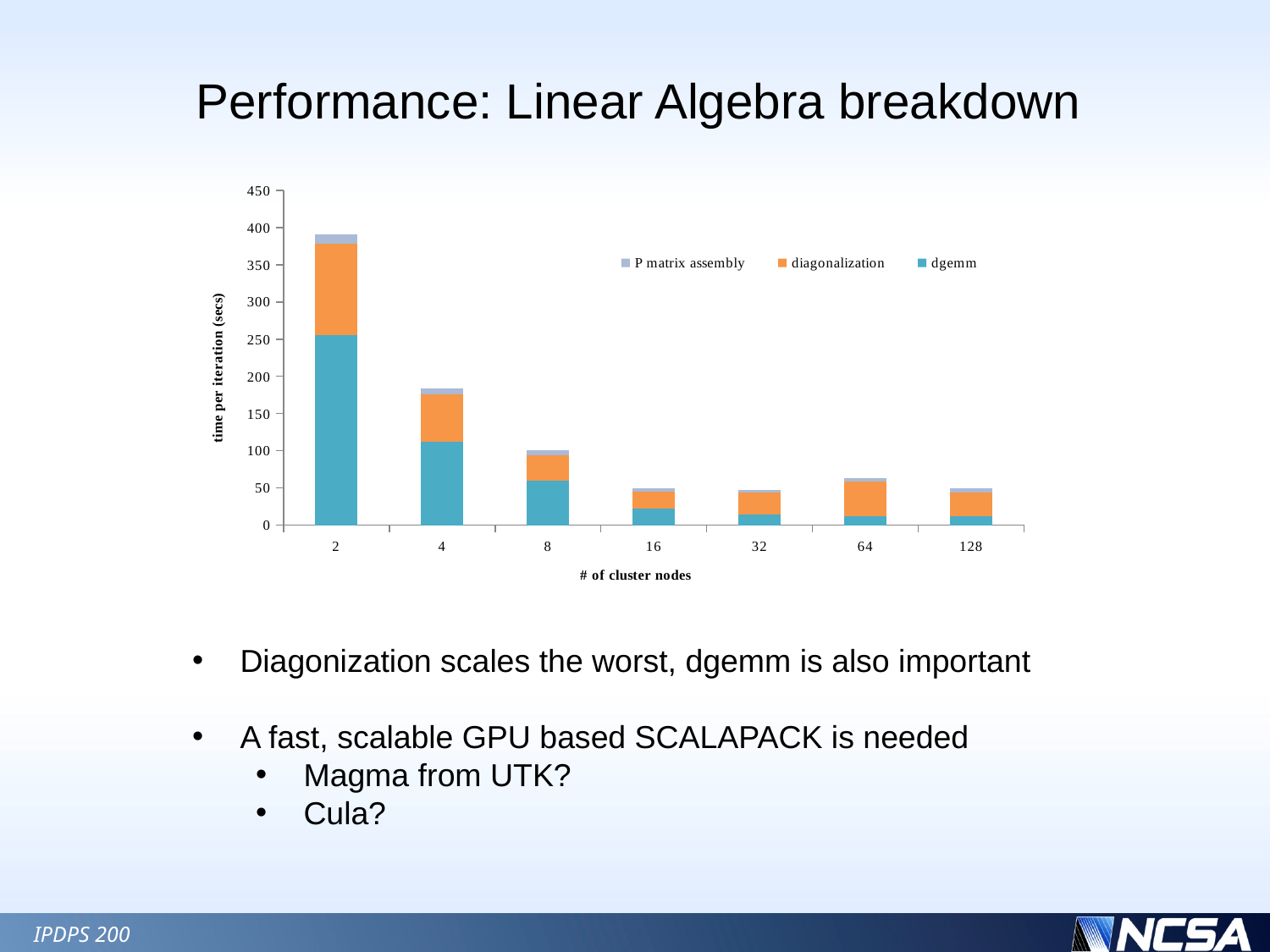
Is the total time per iteration for 2 cluster nodes greater or less than 350? greater How many cluster-node categories are shown on the x axis? 7 What kind of chart is shown on the slide? bar chart Which has a larger total time per iteration, 2 cluster nodes or 4 cluster nodes? 2 cluster nodes How many series does the legend list? 3 What is the label of the y axis? time per iteration (secs) Is the dgemm value for 4 cluster nodes greater or less than 100? greater Is the total time per iteration for 64 cluster nodes greater or less than 50? greater Which number of cluster nodes has the highest total time per iteration? 2 Does the total time per iteration generally rise or fall as the number of cluster nodes increases? fall